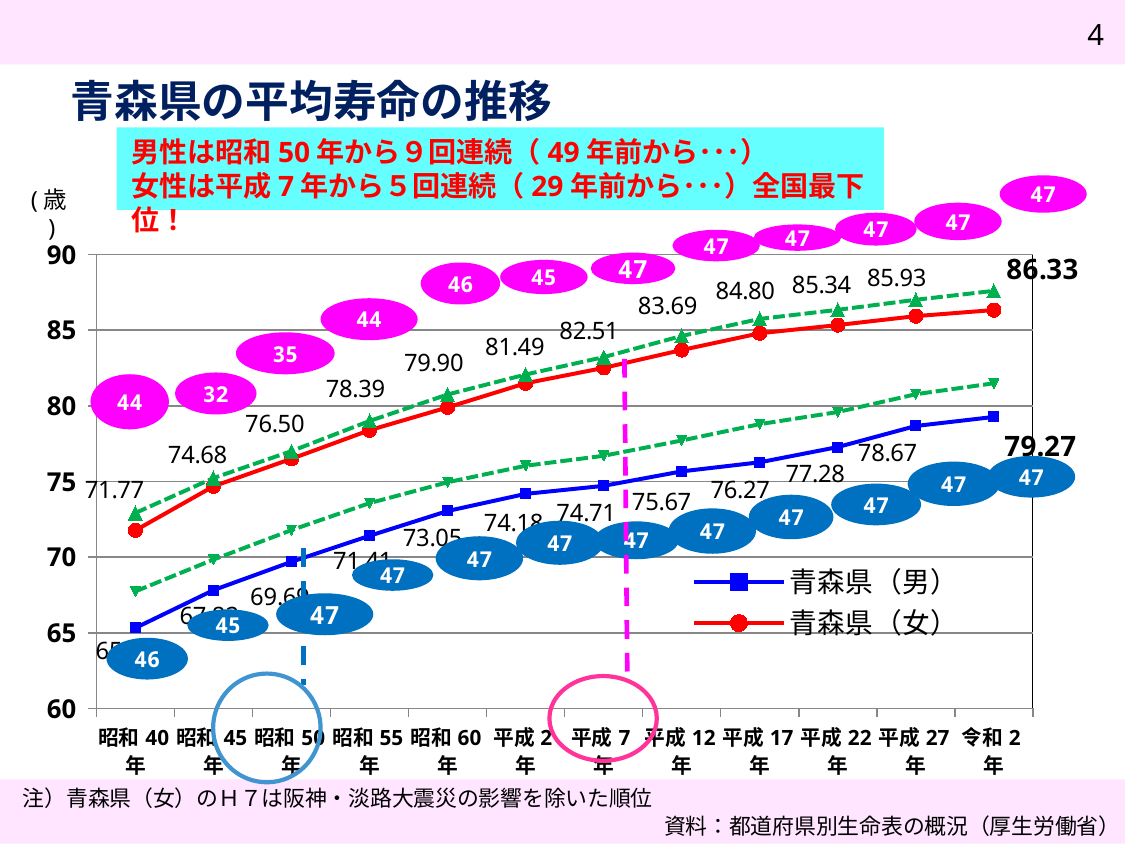
Is the value for 青森県（男） in 昭和40年 greater or less than 70? less What kind of chart is shown on the slide? line chart What is the difference between 青森県（女） and 青森県（男） in 令和2年? 7.06 What is the value for 青森県（女） in 昭和40年? 71.77 What is the value for 青森県（男） in 令和2年? 79.27 By how much did the value for 青森県（女） increase from 昭和40年 to 令和2年? 14.56 What is the value for 青森県（女） in 平成7年? 82.51 How many time points are shown along the x axis? 12 Which is larger in 平成17年, 青森県（男） or 青森県（女）? 青森県（女） What is the value for 青森県（女） in 令和2年? 86.33 What is the value for 青森県（男） in 平成7年? 74.71 How many series does the legend list? 2